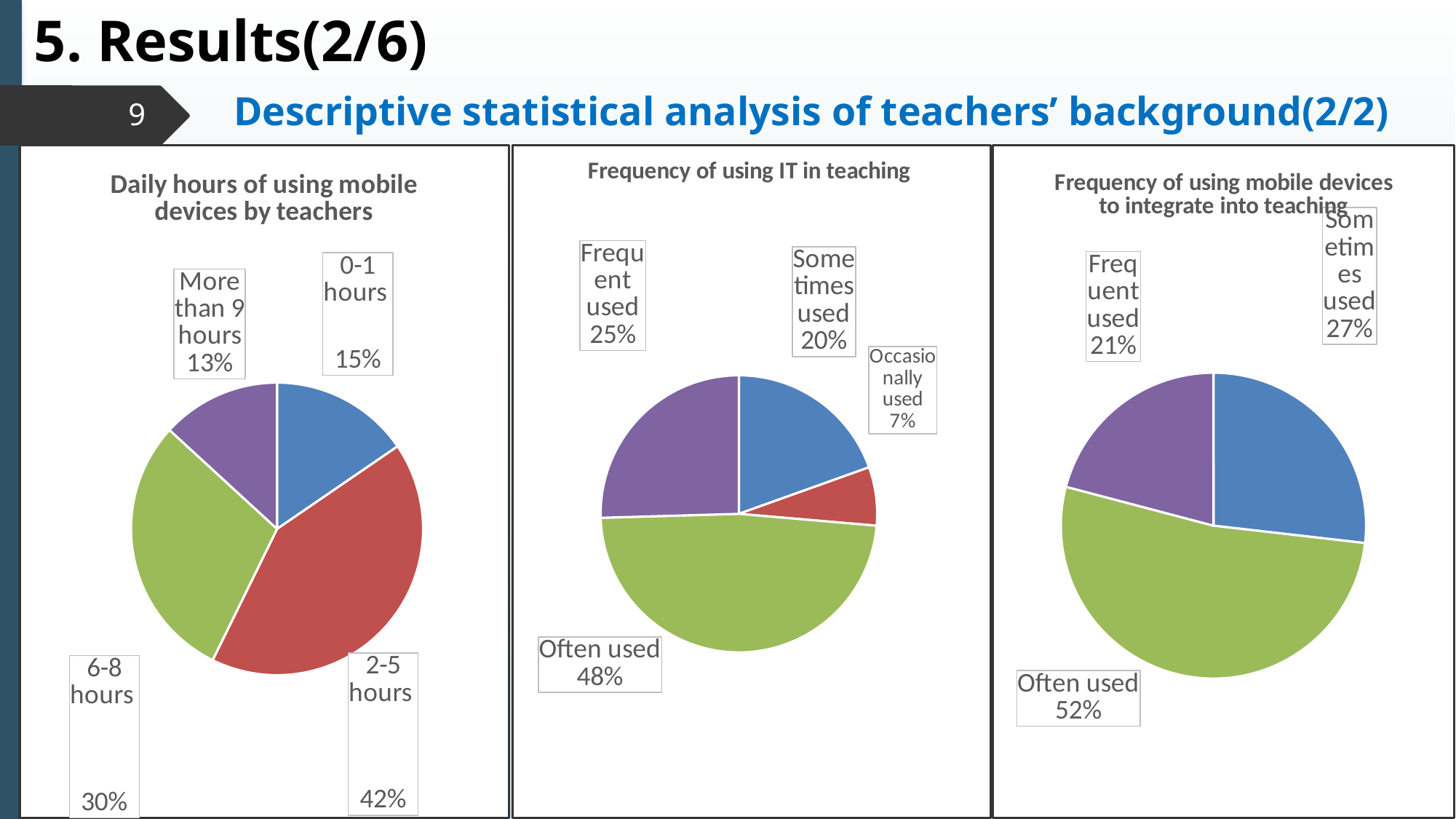
In the 'Frequency of using IT in teaching' chart, which category has the largest share? Often used What type of chart is 'Frequency of using IT in teaching'? Pie chart How many slices does the 'Frequency of using mobile devices to integrate into teaching' pie chart have? 3 In the 'Daily hours of using mobile devices by teachers' chart, what is the difference between the 6-8 hours share and the 0-1 hours share? 15% In the 'Frequency of using IT in teaching' chart, what percentage is 'Occasionally used'? 7% In the 'Frequency of using mobile devices to integrate into teaching' chart, what is the difference between 'Sometimes used' and 'Frequent used'? 6% In the 'Daily hours of using mobile devices by teachers' chart, what share of teachers use mobile devices 2-5 hours daily? 42% In the 'Daily hours of using mobile devices by teachers' chart, which category has the smallest share? More than 9 hours How many pie charts are shown on the slide? 3 How many slices does the 'Daily hours of using mobile devices by teachers' pie chart have? 4 In the 'Frequency of using mobile devices to integrate into teaching' chart, what percentage is 'Often used'? 52% In the 'Frequency of using IT in teaching' chart, which is larger: 'Frequent used' or 'Sometimes used'? Frequent used